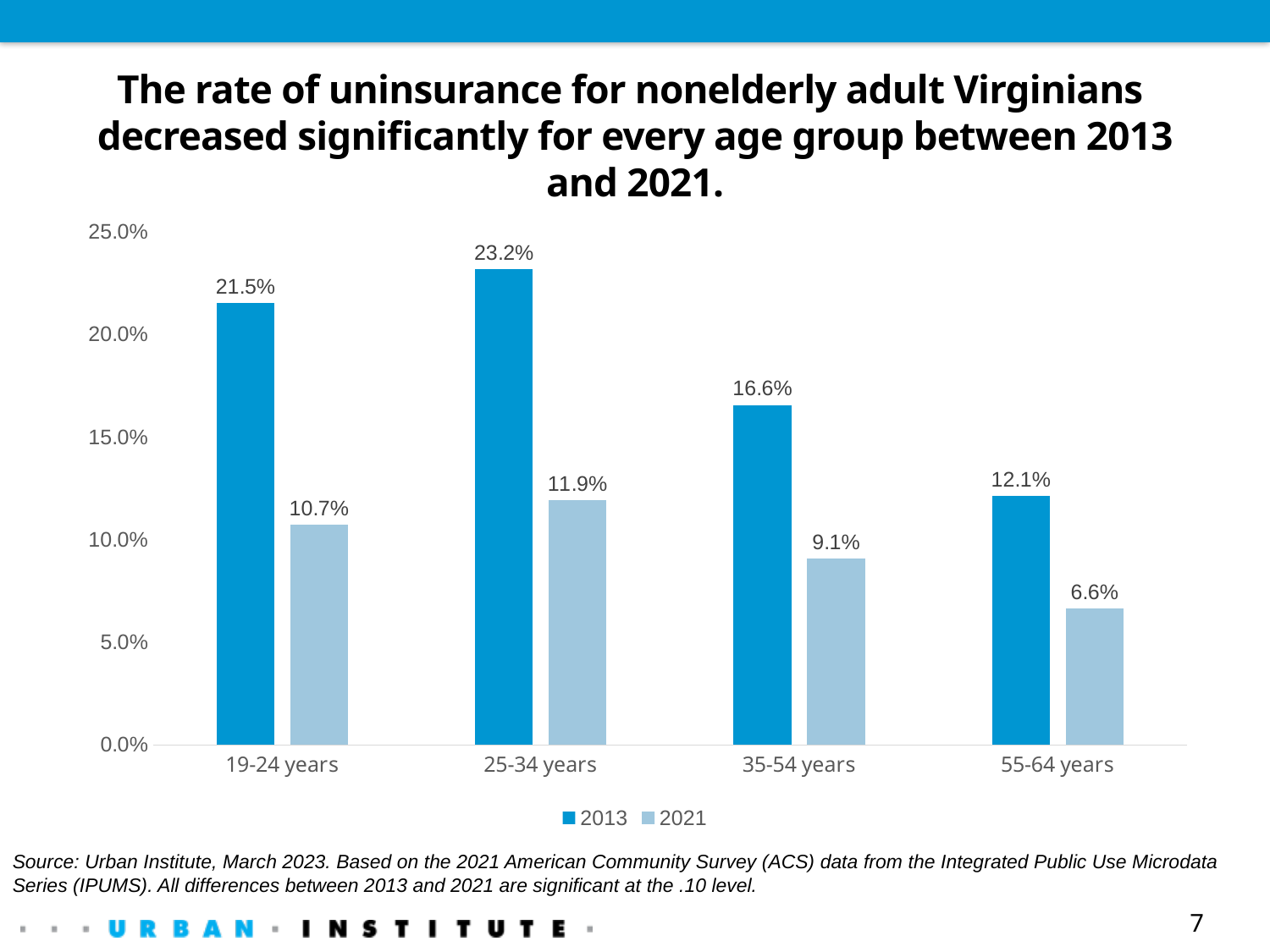
What was the uninsurance rate for 55-64 years in 2021? 6.6% Which age group had the highest uninsurance rate in 2013? 25-34 years Which is larger: the 2021 rate for 19-24 years or the 2021 rate for 25-34 years? 25-34 years How many series does the legend list? 2 How many age groups are shown on the chart? 4 What was the uninsurance rate for 35-54 years in 2021? 9.1% By how many percentage points did the uninsurance rate for 25-34 years fall between 2013 and 2021? 11.3 percentage points Do the 2013 uninsurance rates rise or fall from 25-34 years to 55-64 years? Fall What was the uninsurance rate for 19-24 years in 2013? 21.5% What is the difference between the 2013 uninsurance rates for 19-24 years and 55-64 years? 9.4 percentage points What kind of chart is shown on the slide? Bar chart Which age group had the lowest uninsurance rate in 2021? 55-64 years